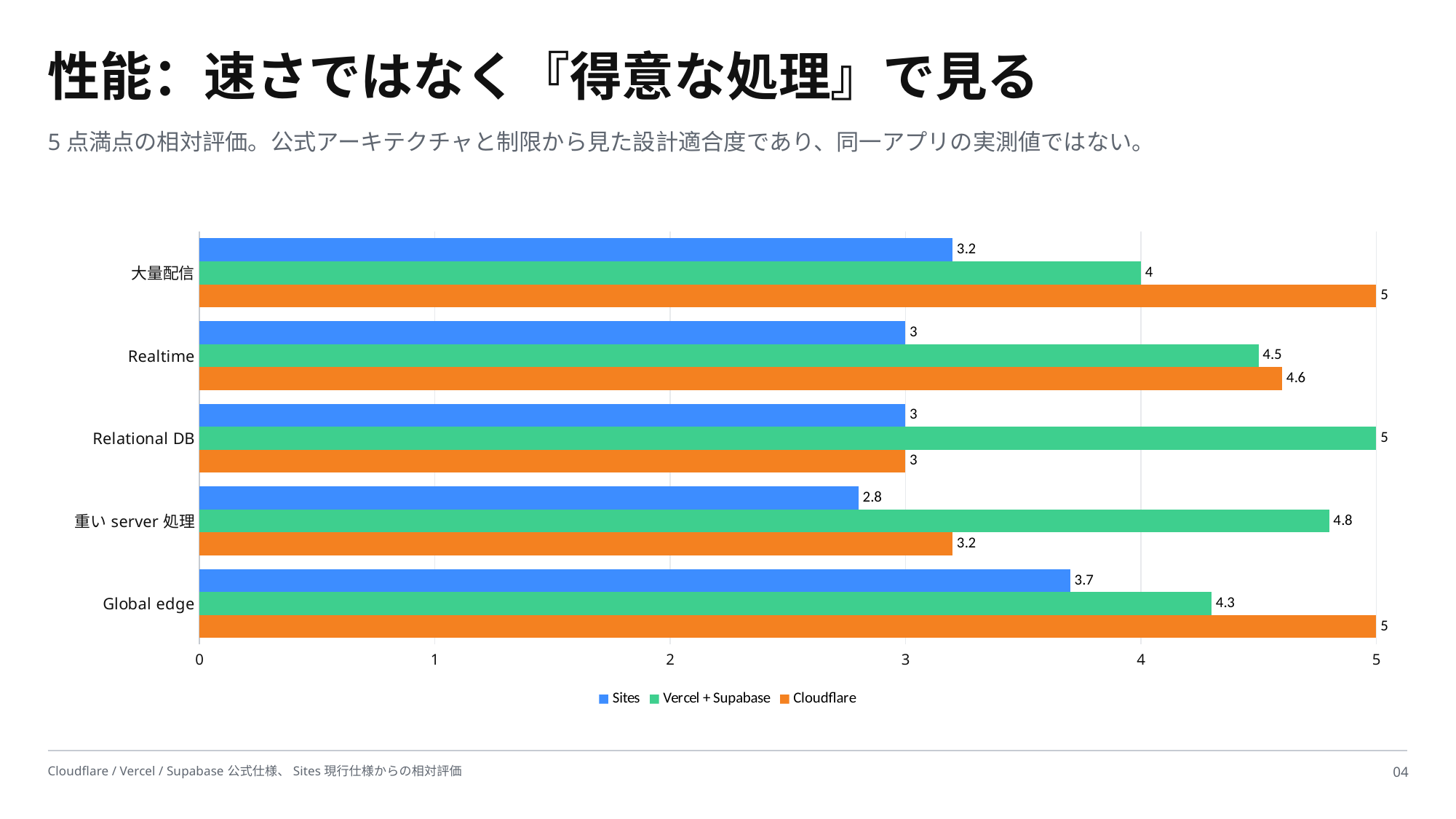
How many series does the legend list? 3 What is the difference between the Vercel + Supabase and Cloudflare values in the 重い server 処理 category? 1.6 What is the value for Vercel + Supabase in the Realtime category? 4.5 Which category has the lowest value for Sites? 重い server 処理 How many categories are shown on the chart? 5 Which colour represents the Cloudflare series in the chart? Orange What is the value for Sites in the 重い server 処理 category? 2.8 Which is larger in the Global edge category: the Sites value or the Vercel + Supabase value? Vercel + Supabase Which series has the highest value in the Relational DB category? Vercel + Supabase What kind of chart is shown on the slide? Bar chart Is the value for Sites in the 大量配信 category greater or less than 3? greater What is the value for Cloudflare in the 大量配信 category? 5